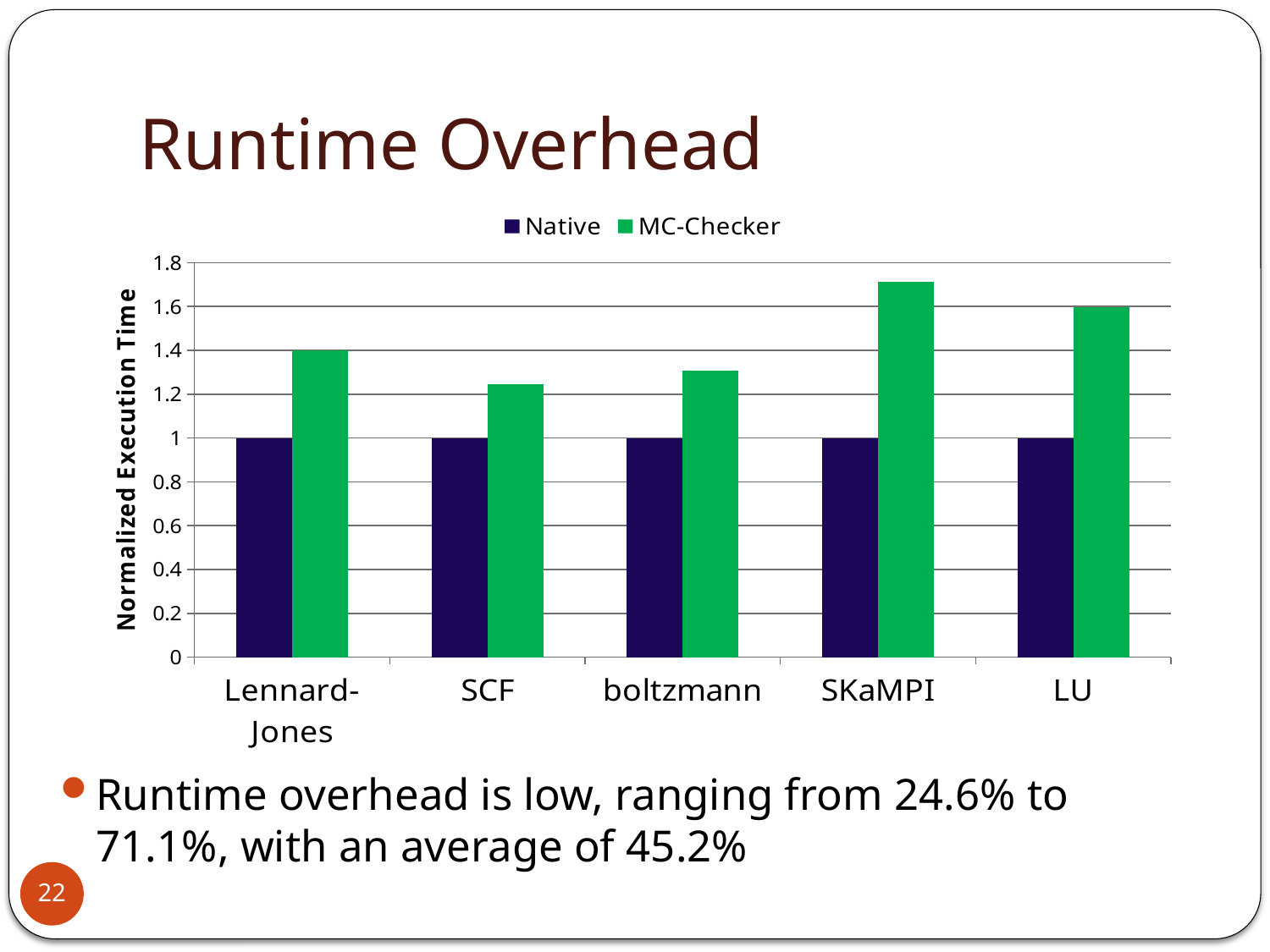
How many series does the legend list? 2 Which is larger, the MC-Checker value for Lennard-Jones or for SCF? Lennard-Jones Is the MC-Checker value for SCF greater or less than 1.4? less What kind of chart is shown on the slide? bar chart Which is larger, the MC-Checker value for SKaMPI or for LU? SKaMPI What is the label of the y axis? Normalized Execution Time What is the Native value for LU? 1 Is the MC-Checker value for SKaMPI greater or less than 1.6? greater What is the Native value for SCF? 1 Is the MC-Checker value for boltzmann greater or less than 1.2? greater Which category has the highest MC-Checker value? SKaMPI How many categories are shown on the x axis? 5